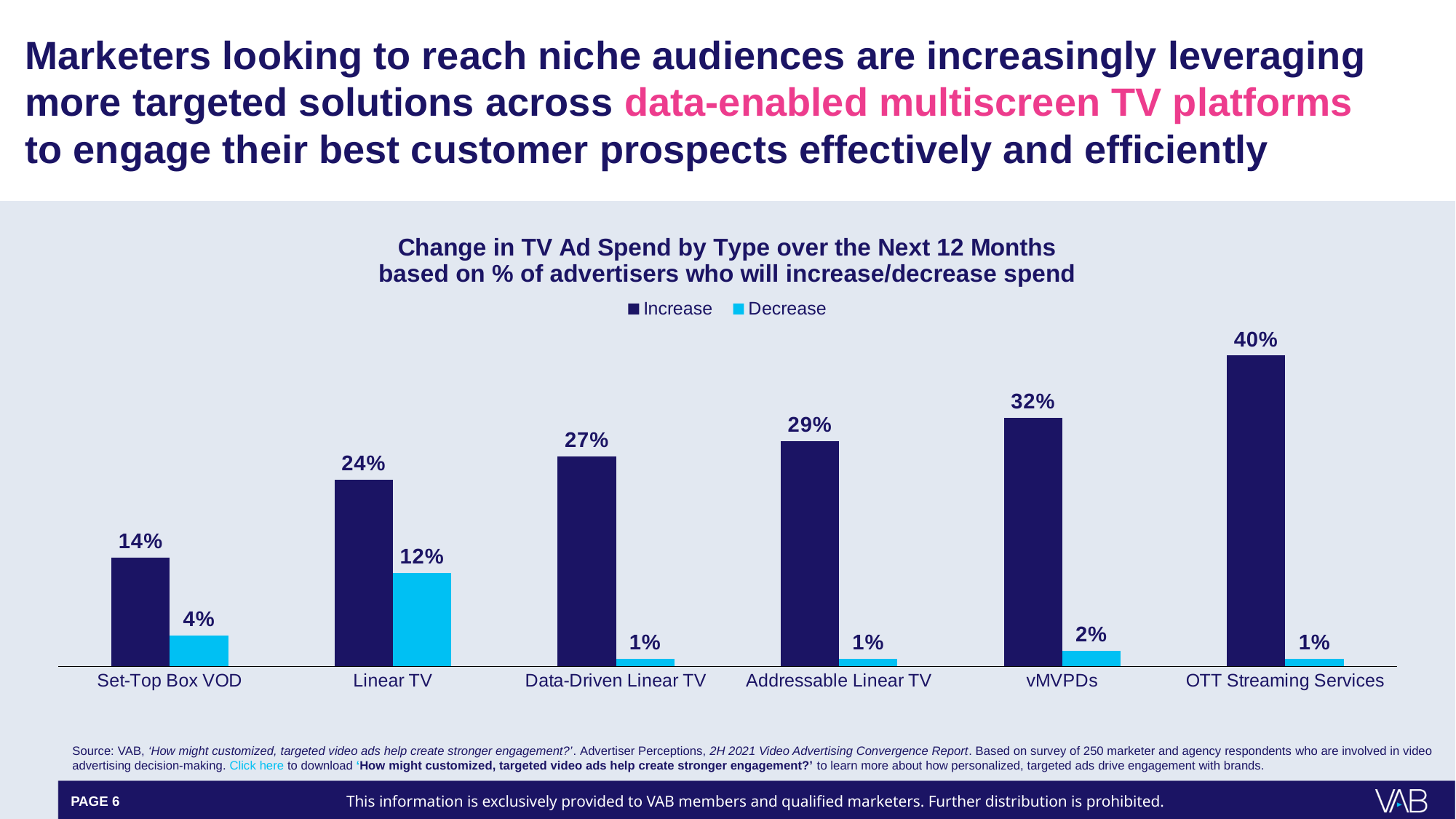
Which category has the lowest Increase value? Set-Top Box VOD What is the Increase value for OTT Streaming Services? 40% How many categories are shown on the x axis? 6 Do the Increase values rise or fall from left to right across the categories? Rise How many series does the legend list? 2 Which is larger, the Decrease value for Set-Top Box VOD or the Decrease value for vMVPDs? Set-Top Box VOD Which category has the highest Increase value? OTT Streaming Services What is the Decrease value for Linear TV? 12% What kind of chart is shown on the slide? Bar chart What is the difference between the Increase values for vMVPDs and Set-Top Box VOD? 18% What is the Increase value for Addressable Linear TV? 29% Which series is shown in light blue in the legend? Decrease